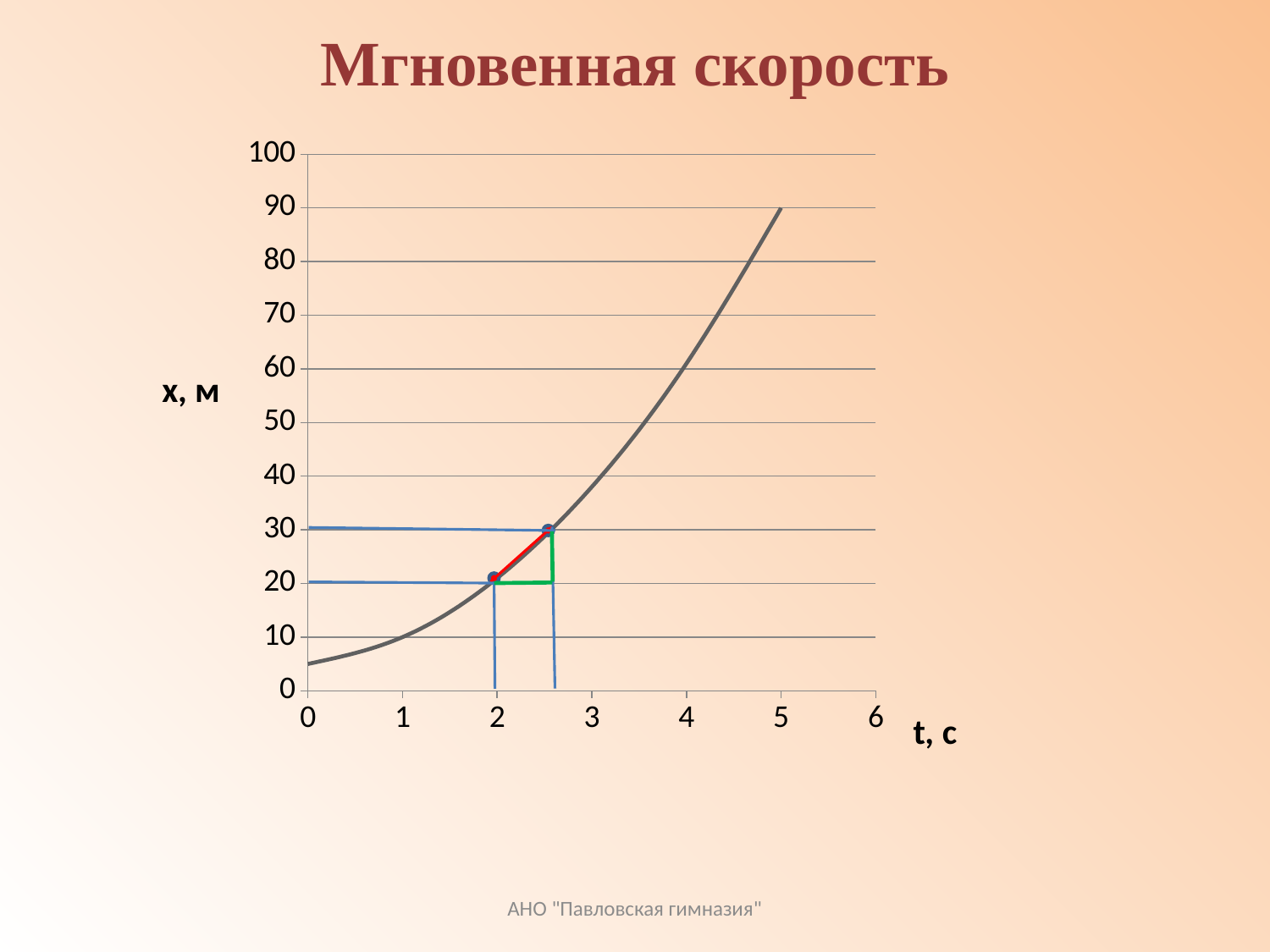
What kind of chart is shown on the slide? line chart Is the value of x at t = 2 greater or less than 30? less Is the value of x at t = 0 greater or less than 10? less Is the value of x at t = 4 greater or less than 50? greater What is the highest value shown on the vertical axis of the chart? 100 Which is larger on the chart: the value of x at t = 3 or at t = 5? t = 5 What is the label of the vertical axis of the chart? x, м Does the value of x rise or fall as t increases along the x axis? rise What is the value of x at t = 5 on the chart? 90 What is the title of the chart on the slide? Мгновенная скорость